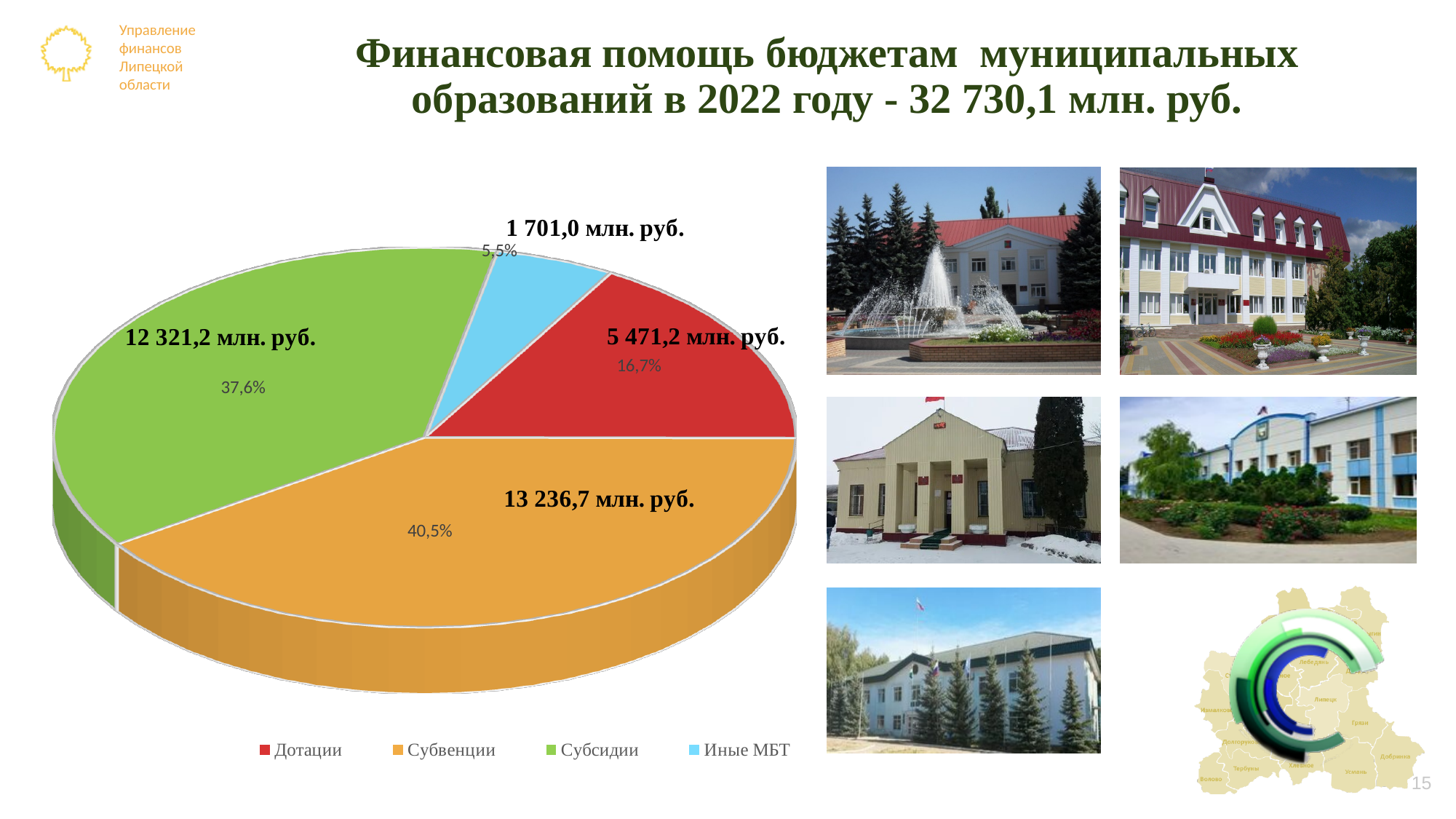
What is the value for Субвенции in the pie chart? 13 236,7 млн. руб. What kind of chart is shown on the slide? Pie chart Which category has the largest slice in the pie chart? Субвенции What colour is the Субвенции slice in the pie chart? Orange What is the value for Иные МБТ in the pie chart? 1 701,0 млн. руб. What is the value for Дотации in the pie chart? 5 471,2 млн. руб. What share of the pie does Иные МБТ represent? 5,5% How many slices does the pie chart have? 4 How many entries does the legend of the pie chart list? 4 Which category has the smallest slice in the pie chart? Иные МБТ What share of the pie does Субсидии represent? 37,6% Which is larger in the pie chart, Дотации or Субсидии? Субсидии